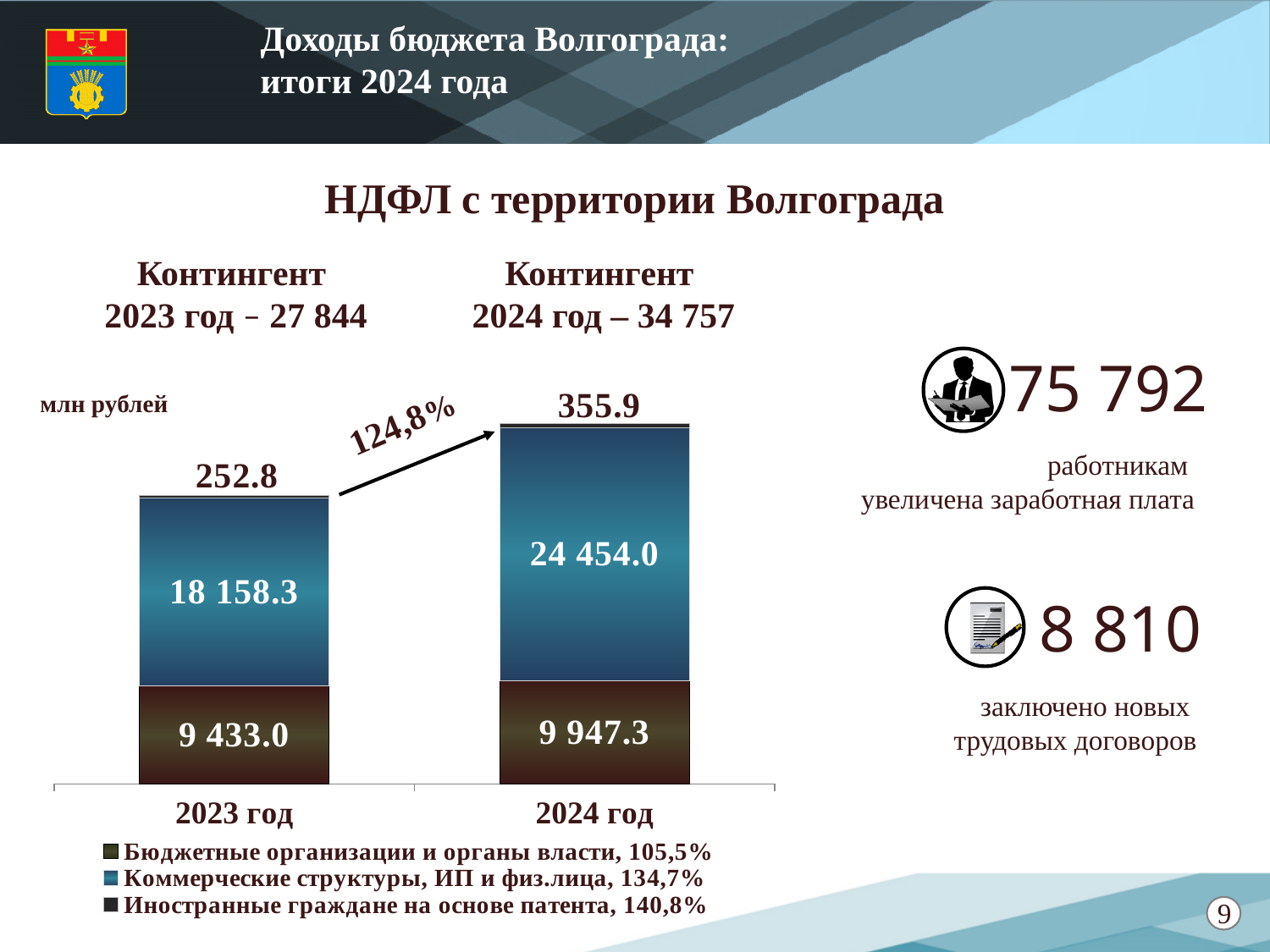
How many categories (years) are shown on the x axis of the chart? 2 By how much did the value for Коммерческие структуры, ИП и физ.лица increase from 2023 год to 2024 год? 6 295.7 What is the value for Бюджетные организации и органы власти in 2024 год? 9 947.3 What kind of chart is shown on the slide? Stacked bar chart Do the bar values rise or fall from 2023 год to 2024 год? Rise What growth percentage is written next to the arrow between the two bars? 124,8% How many series does the chart legend list? 3 What is the difference between the 2024 год and 2023 год values for Бюджетные организации и органы власти? 514.3 In 2024 год, which segment is larger: Коммерческие структуры, ИП и физ.лица or Бюджетные организации и органы власти? Коммерческие структуры, ИП и физ.лица What is the value for Коммерческие структуры, ИП и физ.лица in 2023 год? 18 158.3 What is the value for Коммерческие структуры, ИП и физ.лица in 2024 год? 24 454.0 What is the value for Бюджетные организации и органы власти in 2023 год? 9 433.0